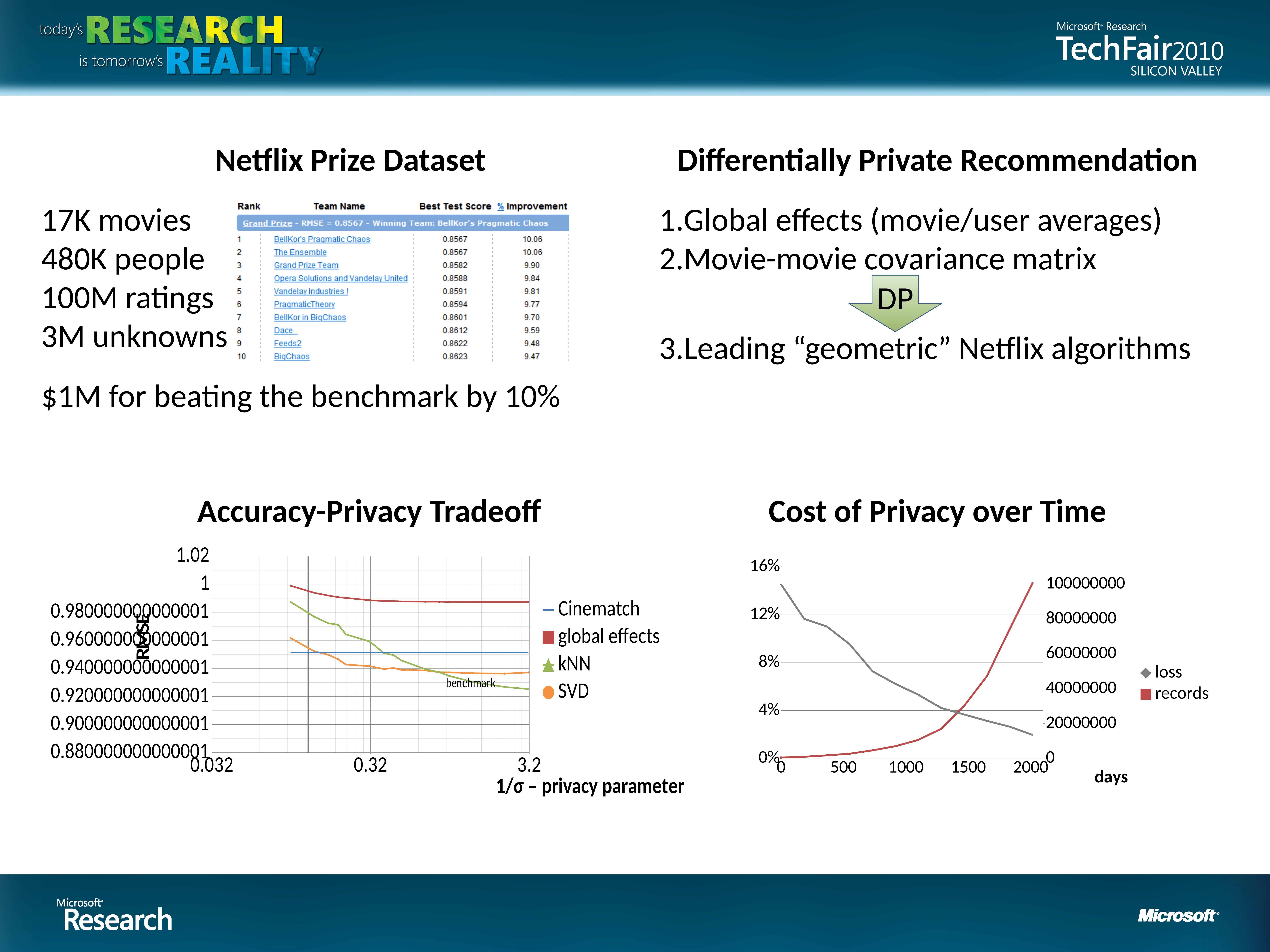
In the "Accuracy-Privacy Tradeoff" chart, which series has the highest RMSE across the plotted range? global effects In the "Cost of Privacy over Time" chart, is the records value at day 2000 greater or less than 80000000? greater In the "Cost of Privacy over Time" chart, is the loss value at day 0 greater or less than 12%? greater In the "Accuracy-Privacy Tradeoff" chart, does the kNN RMSE rise or fall as the privacy parameter increases along the x axis? fall What is the x-axis label of the "Accuracy-Privacy Tradeoff" chart? 1/σ – privacy parameter In the "Cost of Privacy over Time" chart, does the loss series rise or fall as days increase? fall In the "Cost of Privacy over Time" chart, does the records series rise or fall as days increase? rise How many series does the legend of the "Cost of Privacy over Time" chart list? 2 What kind of chart is the "Accuracy-Privacy Tradeoff" chart? line chart In the "Accuracy-Privacy Tradeoff" chart, which series has the lowest RMSE at the right end of the x axis (near 3.2)? kNN In the "Accuracy-Privacy Tradeoff" chart, is the Cinematch RMSE greater or less than 0.96? less How many series does the legend of the "Accuracy-Privacy Tradeoff" chart list? 4